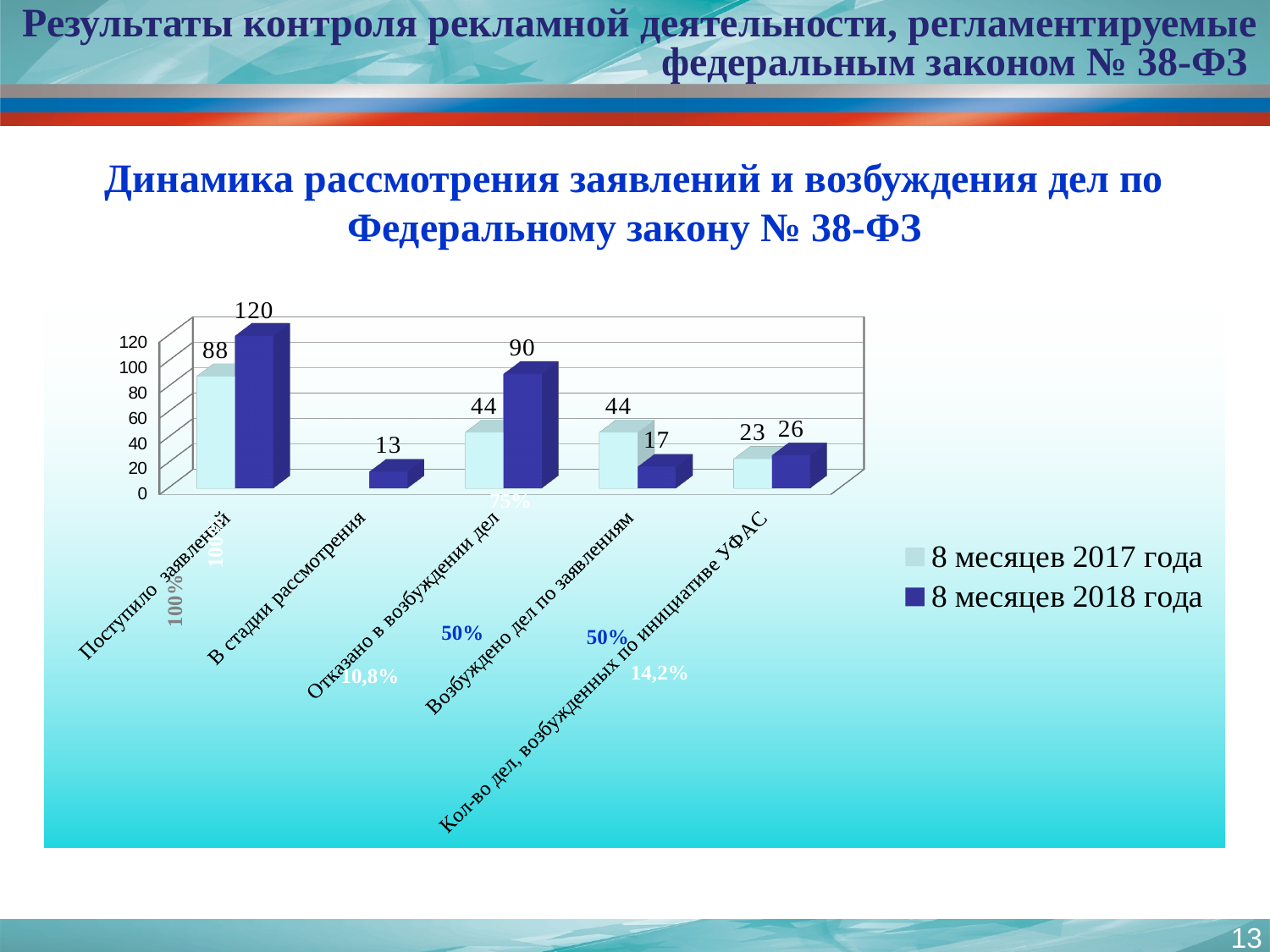
What is the difference between the 2018 and 2017 values for "Поступило заявлений"? 32 Which category has the highest value for 8 месяцев 2018 года? Поступило заявлений How many categories are shown on the x axis of the chart? 5 What is the value for "Поступило заявлений" for 8 месяцев 2018 года? 120 For "Возбуждено дел по заявлениям", which is larger: the value for 8 месяцев 2017 года or for 8 месяцев 2018 года? 8 месяцев 2017 года How many series does the chart legend list? 2 Which series is shown in dark blue in the legend? 8 месяцев 2018 года What is the value for "Возбуждено дел по заявлениям" for 8 месяцев 2018 года? 17 What is the value for "Отказано в возбуждении дел" for 8 месяцев 2018 года? 90 What is the value for "В стадии рассмотрения" for 8 месяцев 2018 года? 13 What is the value for "Поступило заявлений" for 8 месяцев 2017 года? 88 What kind of chart is shown on the slide? bar chart